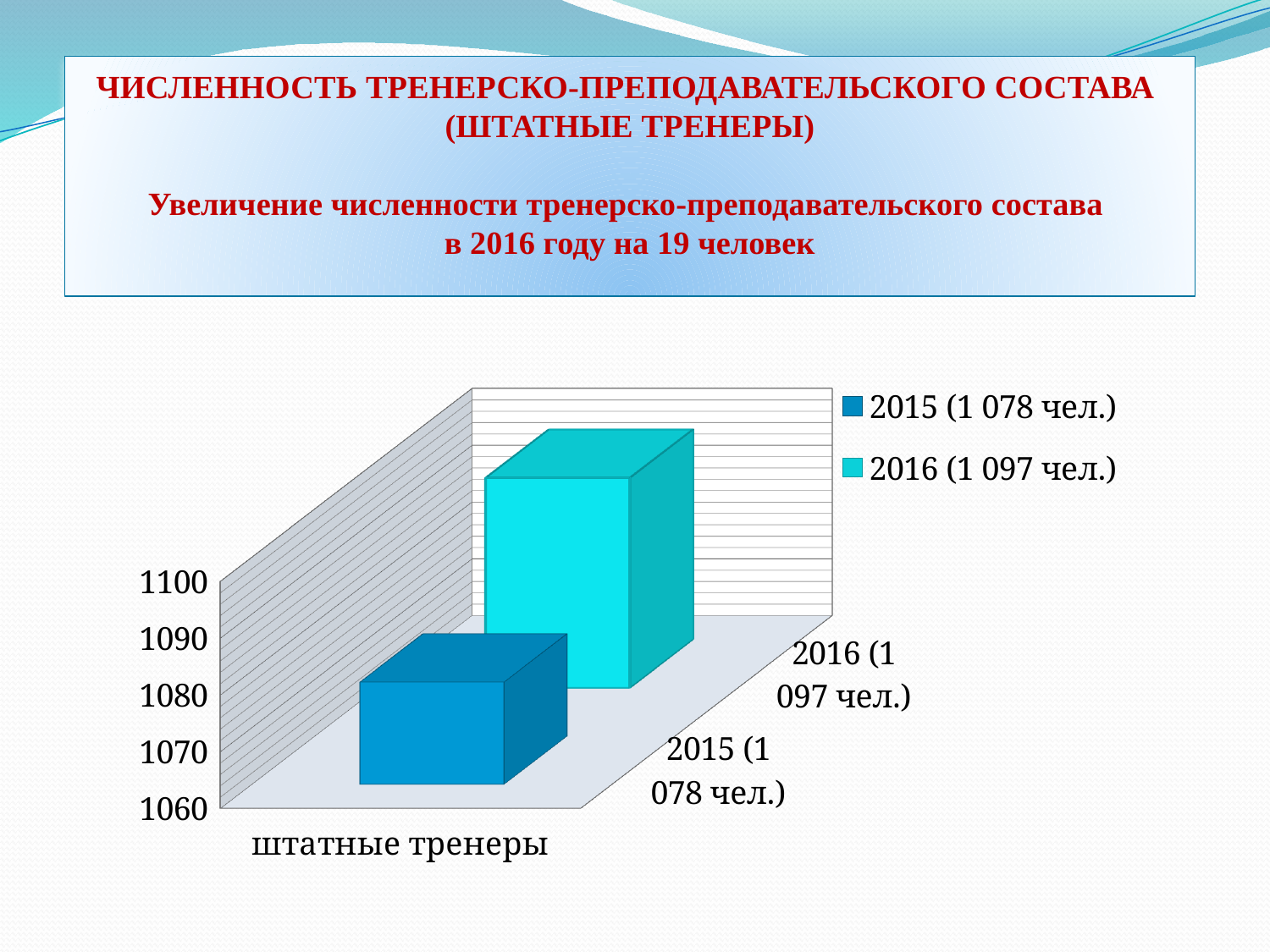
Which series has the lowest value? 2015 (1 078 чел.) Is the value for 2016 greater or less than 1090? greater How many series does the legend list? 2 How many categories are shown on the x axis? 1 What is the value for the 2015 series? 1 078 чел. What is the difference between the 2016 value and the 2015 value? 19 What kind of chart is shown on the slide? bar chart Which series has the higher value, 2015 or 2016? 2016 Is the value for 2015 greater or less than 1090? less What is the value for the 2016 series? 1 097 чел. What is the category label shown on the x axis? штатные тренеры Which series has the highest value? 2016 (1 097 чел.)